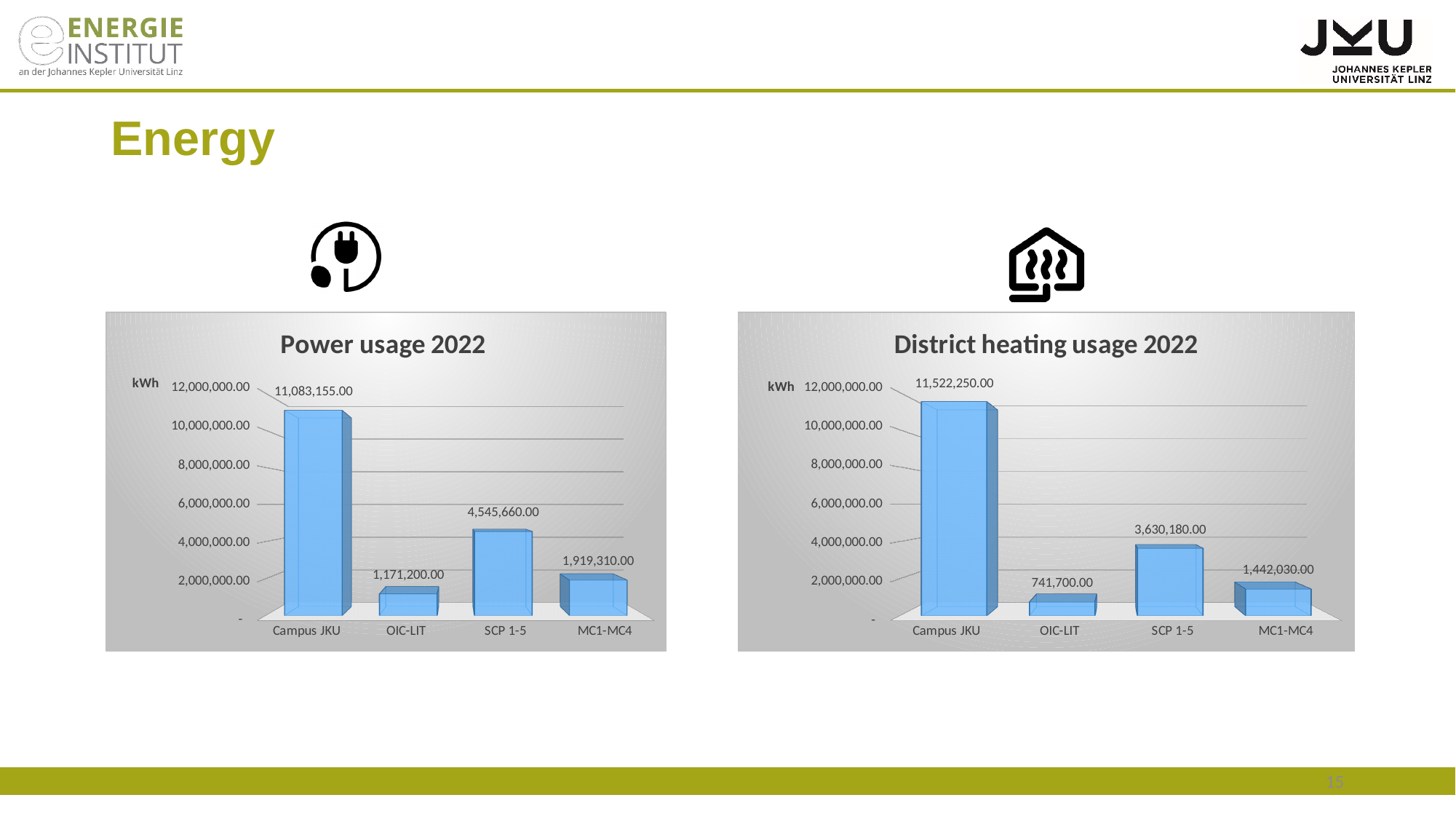
What kind of chart is the 'Power usage 2022' chart? Bar chart How many categories are shown in the 'District heating usage 2022' chart? 4 In the 'Power usage 2022' chart, what is the value for SCP 1-5? 4,545,660.00 In the 'District heating usage 2022' chart, what is the value for MC1-MC4? 1,442,030.00 In the 'Power usage 2022' chart, what is the difference between the values for SCP 1-5 and MC1-MC4? 2,626,350.00 In the 'Power usage 2022' chart, what is the value for Campus JKU? 11,083,155.00 In the 'District heating usage 2022' chart, what is the value for OIC-LIT? 741,700.00 In the 'Power usage 2022' chart, which category has the lowest value? OIC-LIT In the 'Power usage 2022' chart, which is larger, the value for OIC-LIT or the value for MC1-MC4? MC1-MC4 In the 'District heating usage 2022' chart, which category has the highest value? Campus JKU In the 'District heating usage 2022' chart, what is the difference between the values for SCP 1-5 and OIC-LIT? 2,888,480.00 What unit is shown on the vertical axis of the 'District heating usage 2022' chart? kWh